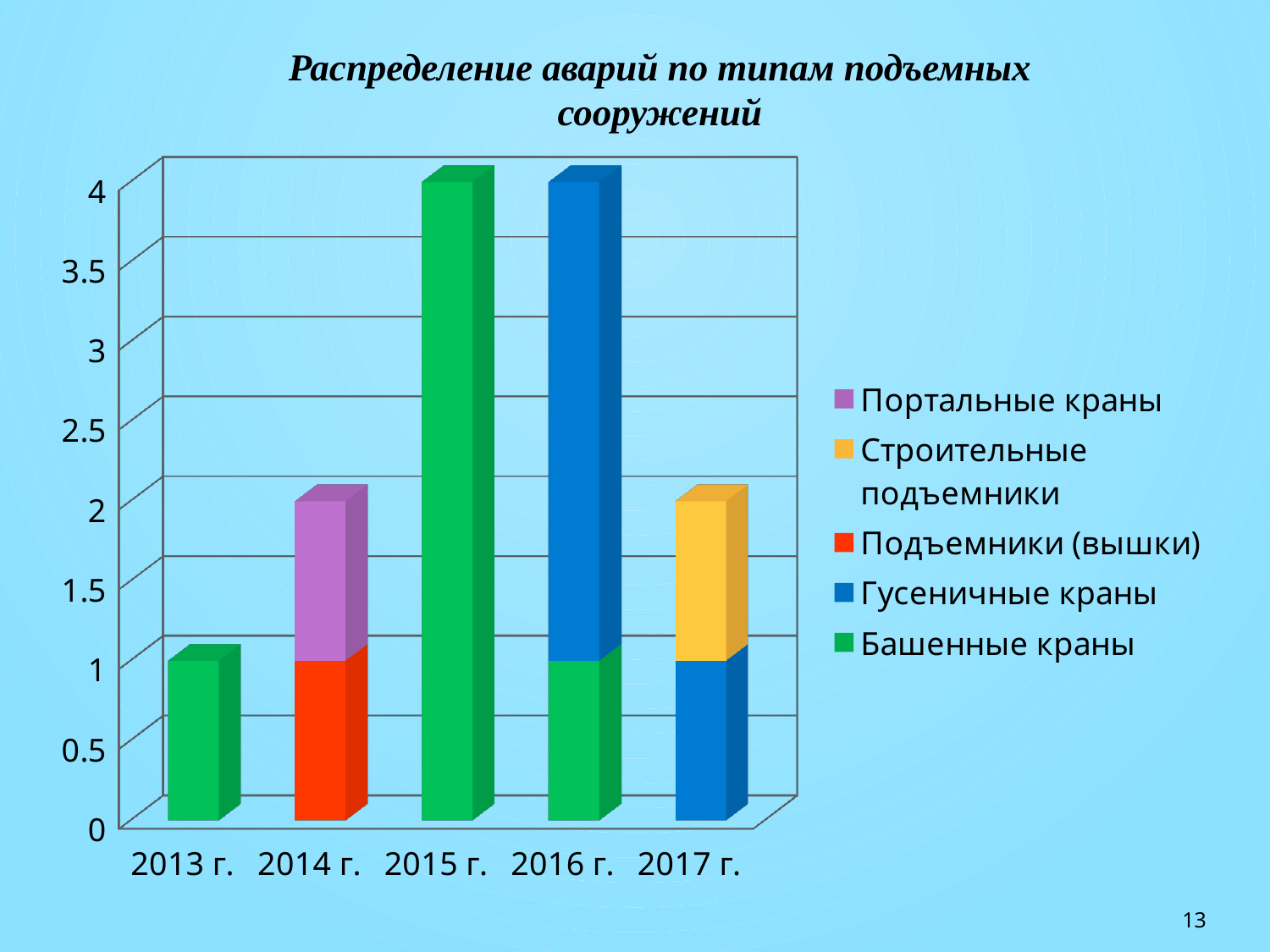
How many years are shown on the x axis? 5 Is the total for 2016 г. greater or less than 3? greater Which is larger, the total for 2015 г. or the total for 2017 г.? 2015 г. What is the title of the chart? Распределение аварий по типам подъемных сооружений What kind of chart is shown on the slide? bar chart What is the total height of the stacked bar for 2017 г.? 2 What is the value for Подъемники (вышки) in 2014 г.? 1 What is the total height of the stacked bar for 2015 г.? 4 How many series does the legend list? 5 What is the value for Башенные краны in 2013 г.? 1 Which year has the lowest total number of accidents? 2013 г. What is the total height of the stacked bar for 2014 г.? 2